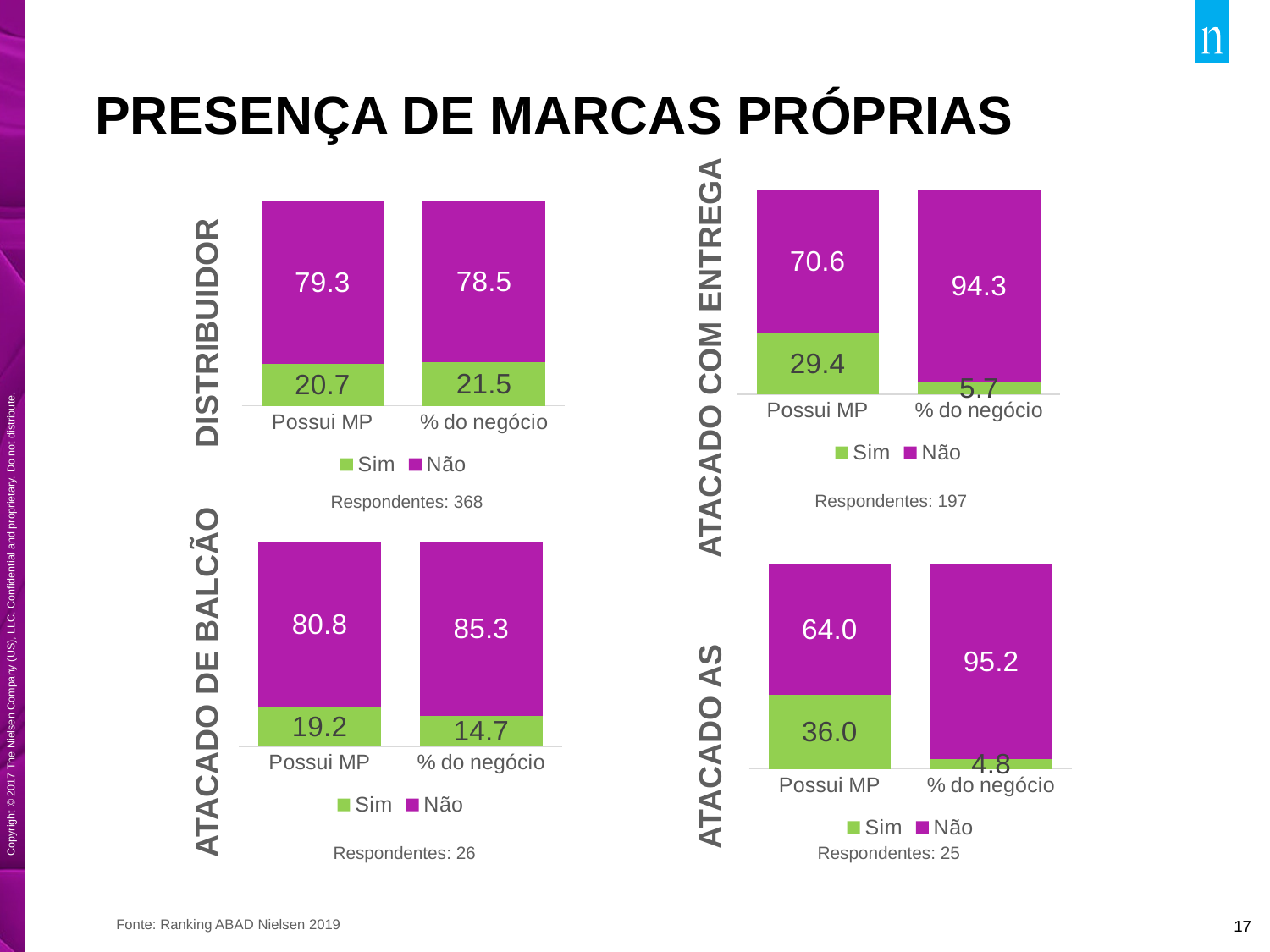
In the ATACADO DE BALCÃO chart, what is the value of Sim for Possui MP? 19.2 What kind of chart is the ATACADO COM ENTREGA chart? Stacked bar chart In the ATACADO DE BALCÃO chart, which category has the higher Sim value, Possui MP or % do negócio? Possui MP In the ATACADO AS chart, what is the total of the stacked bar for % do negócio? 100.0 How many series does the legend of the DISTRIBUIDOR chart list? 2 How many categories are shown on the x axis of the ATACADO AS chart? 2 How many respondents are reported for the ATACADO DE BALCÃO chart? 26 In the DISTRIBUIDOR chart, what is the value of Não for Possui MP? 79.3 In the DISTRIBUIDOR chart, what is the value of Sim for % do negócio? 21.5 In the ATACADO COM ENTREGA chart, what is the difference between the Não values for % do negócio and Possui MP? 23.7 In the ATACADO AS chart, what is the value of Sim for Possui MP? 36.0 In the ATACADO COM ENTREGA chart, what is the value of Não for % do negócio? 94.3